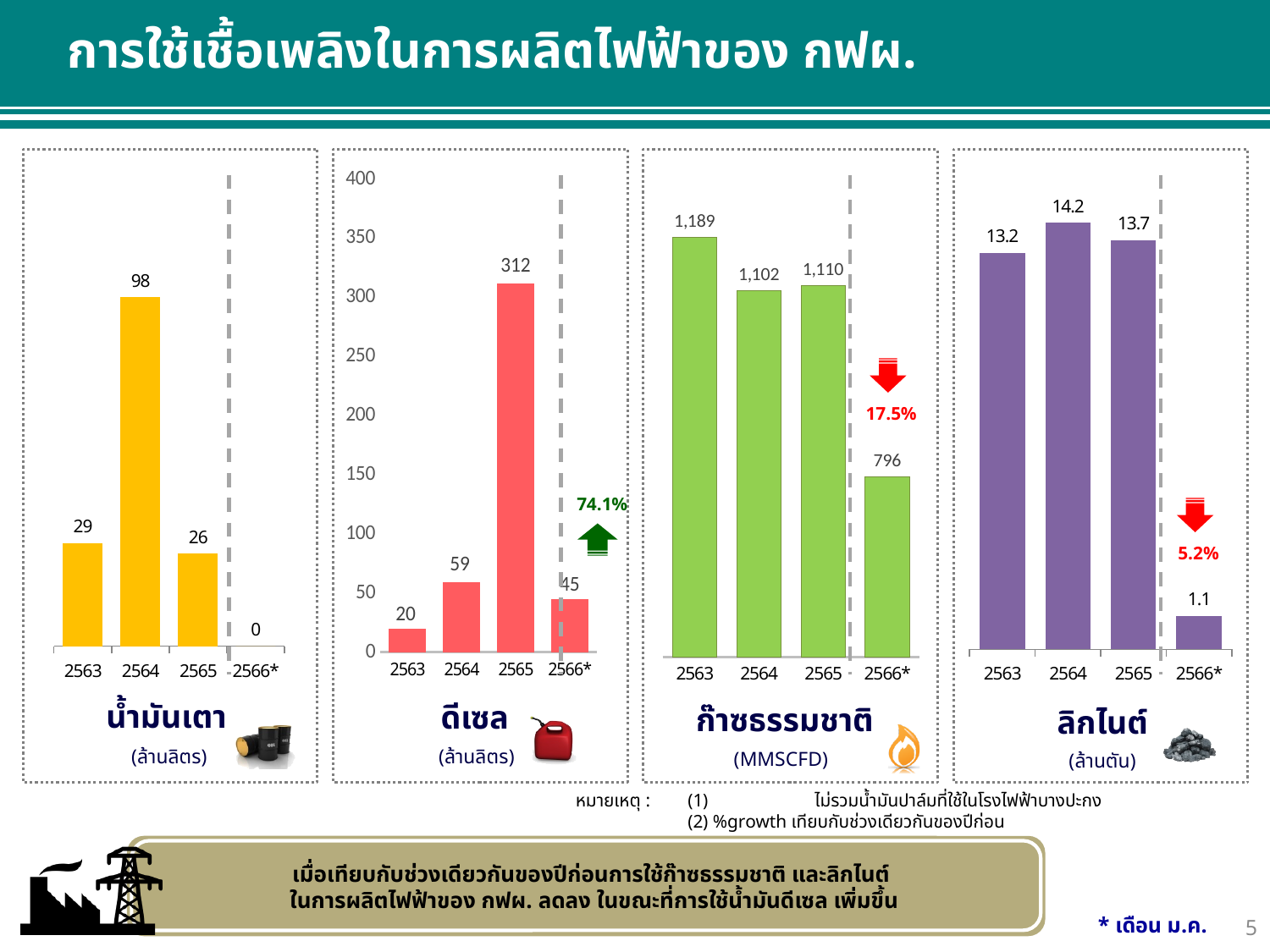
In the น้ำมันเตา chart, what is the value for 2564? 98 In the ดีเซล chart, what is the value for 2565? 312 In the ดีเซล chart, what is the difference between the values for 2566* and 2563? 25 In the ก๊าซธรรมชาติ chart, what is the value for 2566*? 796 In the ลิกไนต์ chart, what is the value for 2564? 14.2 How many years are shown on the x axis of the ลิกไนต์ chart? 4 In the ก๊าซธรรมชาติ chart, what is the difference between the values for 2563 and 2566*? 393 In the ลิกไนต์ chart, which year has the lowest value? 2566* In the ก๊าซธรรมชาติ chart, which is larger, the value for 2564 or 2565? 2565 In the ดีเซล chart, which year has the highest value? 2565 In the น้ำมันเตา chart, which year has the lowest value? 2566* What type of chart is the ดีเซล chart? bar chart